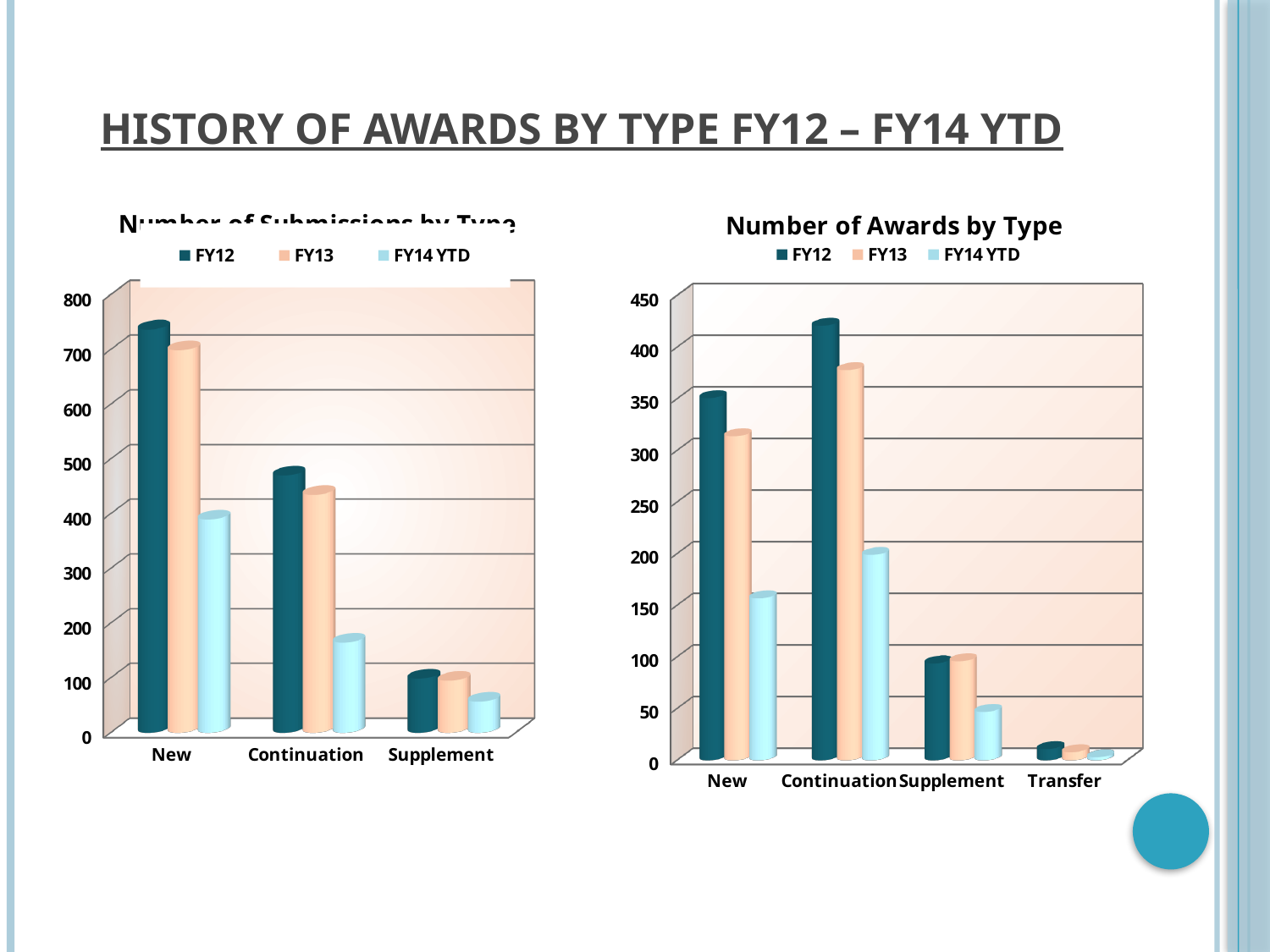
In the "Number of Awards by Type" chart, which is larger: the FY12 value for New or the FY12 value for Continuation? Continuation In the "Number of Submissions by Type" chart, do the FY12 values rise or fall from New to Supplement? fall How many series does the legend of the "Number of Awards by Type" chart list? 3 In the "Number of Submissions by Type" chart, is the FY12 value for New greater or less than 700? greater In the "Number of Submissions by Type" chart, which category has the highest FY12 value? New In the "Number of Awards by Type" chart, which category has the lowest FY14 YTD value? Transfer How many categories are shown on the x axis of the "Number of Awards by Type" chart? 4 In the "Number of Submissions by Type" chart, is the FY14 YTD value for Continuation greater or less than 200? less In the "Number of Awards by Type" chart, which category has the highest FY12 value? Continuation What kind of chart is the "Number of Submissions by Type" chart? bar chart In the "Number of Awards by Type" chart, is the FY14 YTD value for New greater or less than 200? less How many categories are shown on the x axis of the "Number of Submissions by Type" chart? 3